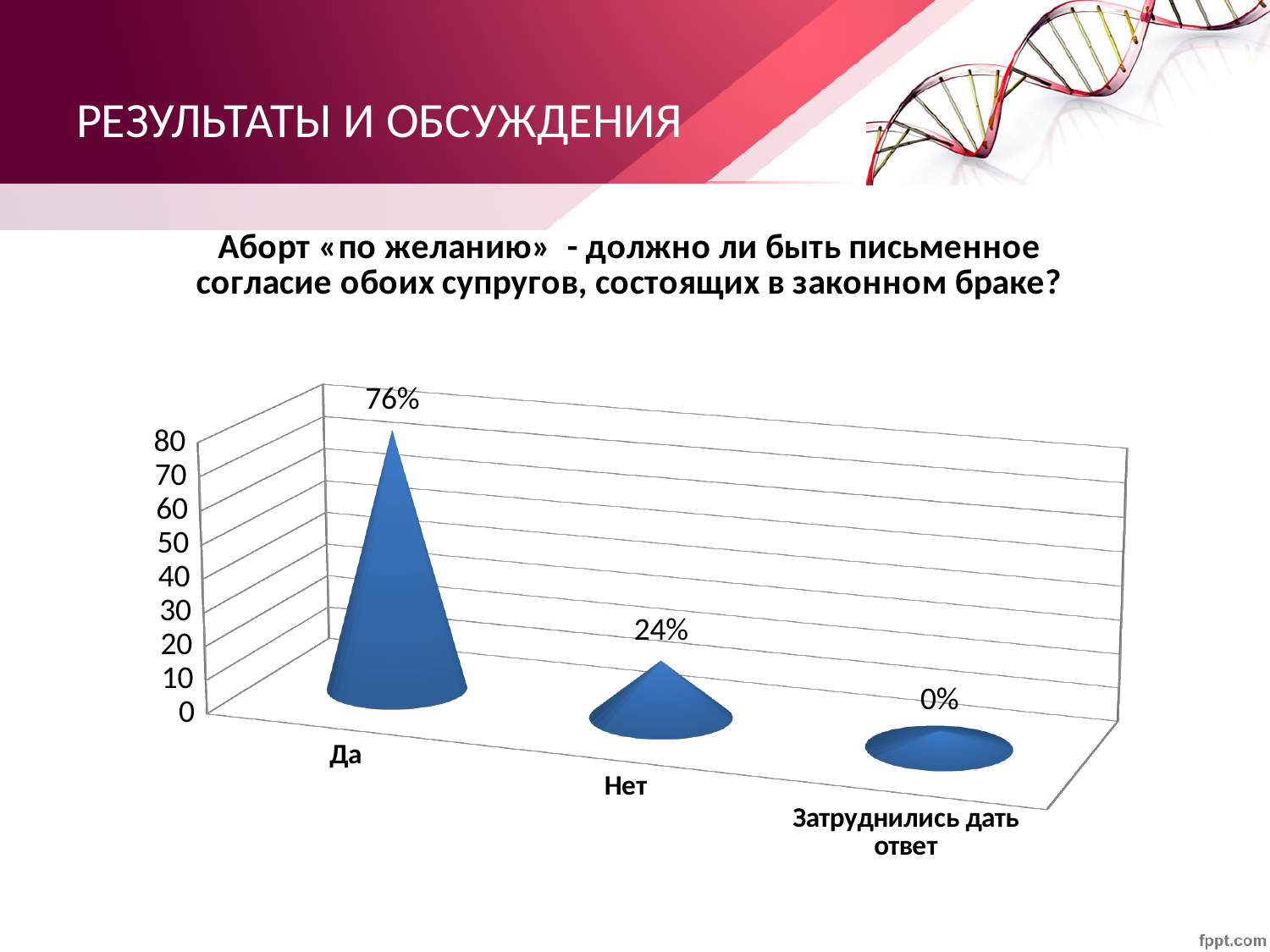
What is the difference between the values for «Да» and «Нет»? 52% What is the value for «Да»? 76% Is the value for «Нет» greater or less than 30? less Which is larger, the value for «Да» or the value for «Нет»? Да How many categories are shown on the chart? 3 Is the value for «Да» greater or less than 50? greater Which category has the lowest value? Затруднились дать ответ What is the value for «Затруднились дать ответ»? 0% What is the maximum value shown on the vertical axis? 80 What is the value for «Нет»? 24% What kind of chart is shown on the slide? bar chart Which category has the highest value? Да